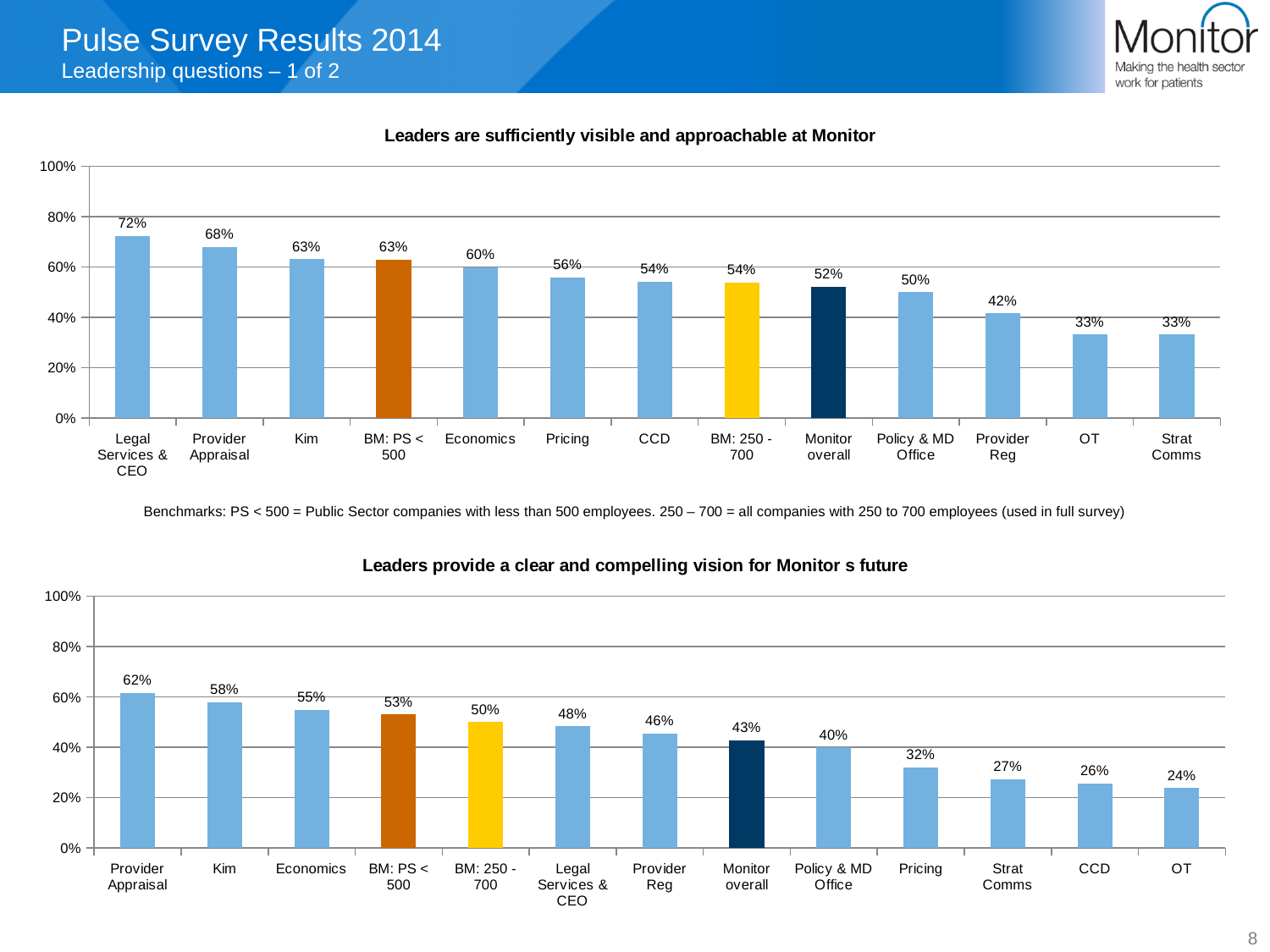
In the chart titled 'Leaders provide a clear and compelling vision for Monitor s future', what is the value for Kim? 58% In the chart titled 'Leaders are sufficiently visible and approachable at Monitor', how many categories are shown on the x axis? 13 In the chart titled 'Leaders provide a clear and compelling vision for Monitor s future', which is larger: Economics or Pricing? Economics In the chart titled 'Leaders provide a clear and compelling vision for Monitor s future', what is the value for BM: 250 - 700? 50% In the chart titled 'Leaders are sufficiently visible and approachable at Monitor', which category has the highest value? Legal Services & CEO In the chart titled 'Leaders are sufficiently visible and approachable at Monitor', what is the value for Monitor overall? 52% What kind of chart is the bottom chart on the slide? bar chart In the chart titled 'Leaders provide a clear and compelling vision for Monitor s future', which category has the lowest value? OT In the chart titled 'Leaders provide a clear and compelling vision for Monitor s future', do the values rise or fall from left to right along the x axis? fall In the chart titled 'Leaders provide a clear and compelling vision for Monitor s future', what is the difference between Provider Appraisal and Monitor overall? 19% In the chart titled 'Leaders are sufficiently visible and approachable at Monitor', what is the difference between Provider Appraisal and Provider Reg? 26% In the chart titled 'Leaders are sufficiently visible and approachable at Monitor', what is the value for Legal Services & CEO? 72%